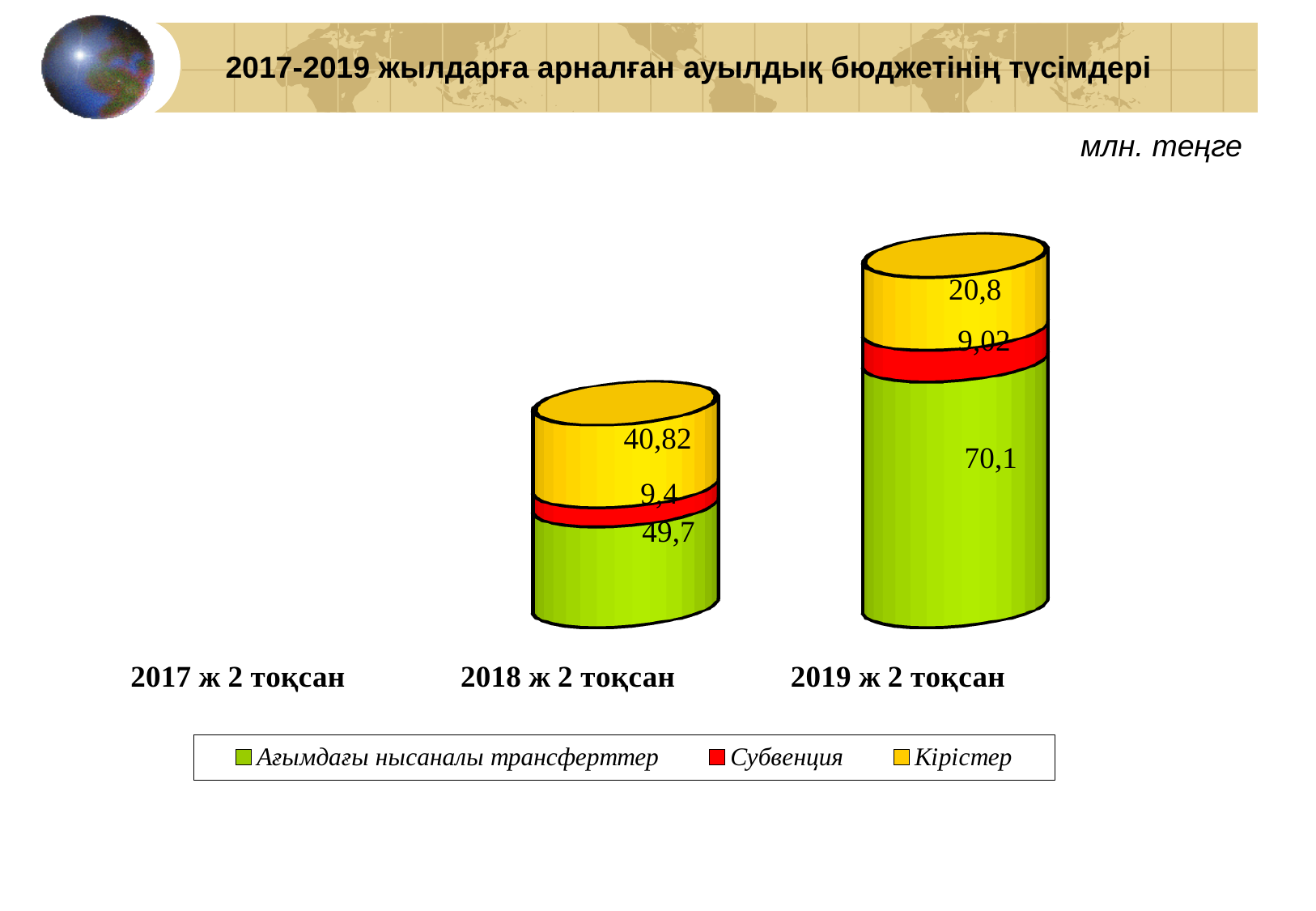
By how much did Ағымдағы нысаналы трансферттер increase from 2018 ж 2 тоқсан to 2019 ж 2 тоқсан? 20,4 Which period has the larger Кірістер value, 2018 ж 2 тоқсан or 2019 ж 2 тоқсан? 2018 ж 2 тоқсан How many series does the legend list? 3 How many categories are shown on the x axis? 3 What is the value of Субвенция for 2018 ж 2 тоқсан? 9,4 What kind of chart is shown on the slide? Stacked bar chart What is the value of Ағымдағы нысаналы трансферттер for 2019 ж 2 тоқсан? 70,1 What is the value of Кірістер for 2018 ж 2 тоқсан? 40,82 What is the value of Кірістер for 2019 ж 2 тоқсан? 20,8 What is the total of the stacked bar for 2018 ж 2 тоқсан? 99,92 What is the value of Ағымдағы нысаналы трансферттер for 2018 ж 2 тоқсан? 49,7 What is the value of Субвенция for 2019 ж 2 тоқсан? 9,02